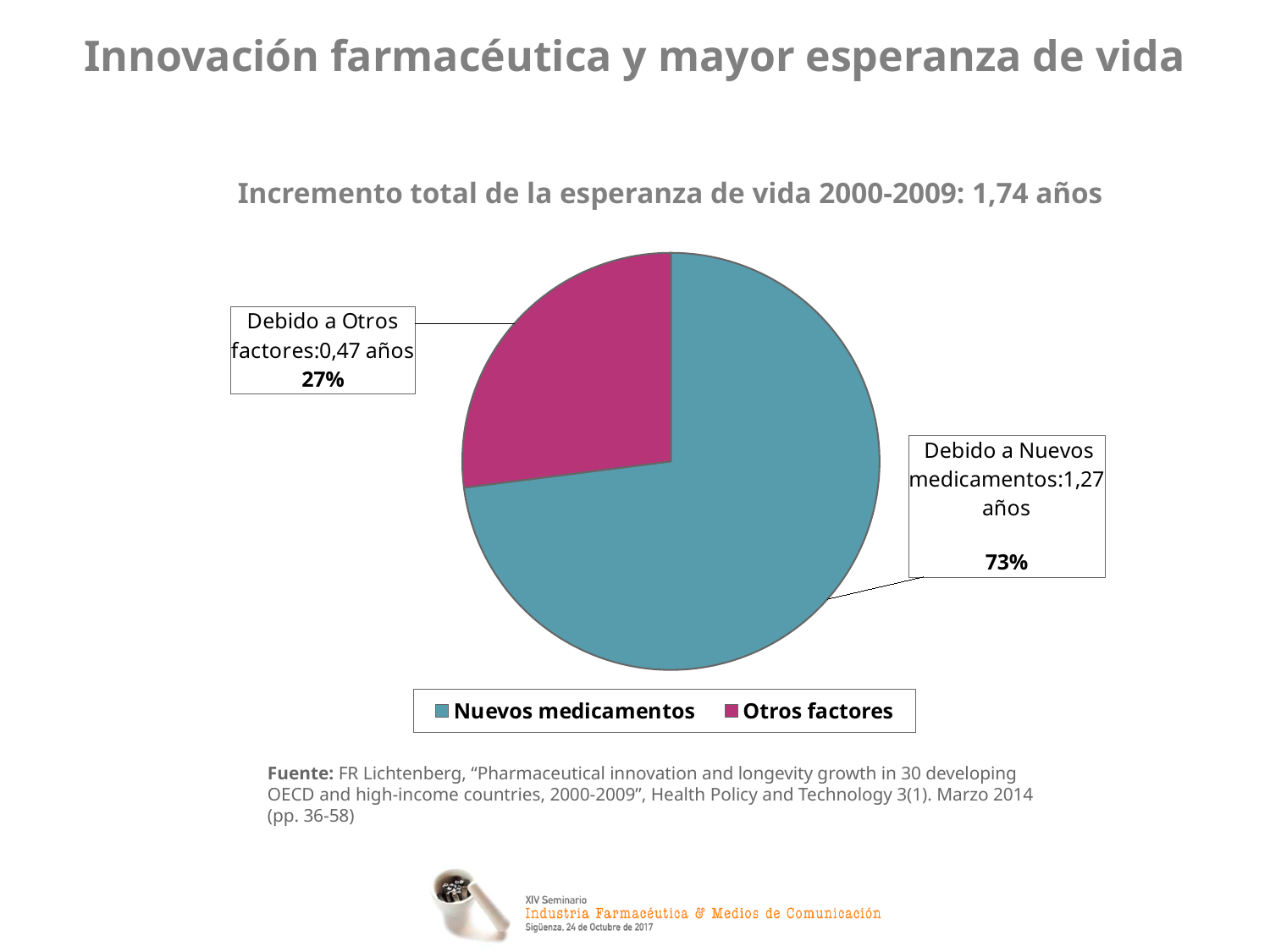
What share of the pie is attributed to Otros factores? 27% What is the title of the chart? Incremento total de la esperanza de vida 2000-2009: 1,74 años Which colour represents Otros factores in the pie chart? magenta Which slice is the largest in the pie chart? Nuevos medicamentos How many years of life expectancy increase are attributed to Nuevos medicamentos? 1,27 años What is the difference in percentage points between the Nuevos medicamentos share and the Otros factores share? 46 percentage points How many years of life expectancy increase are attributed to Otros factores? 0,47 años What share of the pie is attributed to Nuevos medicamentos? 73% Which slice is the smallest in the pie chart? Otros factores How many entries does the legend list? 2 What kind of chart is shown on the slide? pie chart How many slices does the pie chart have? 2